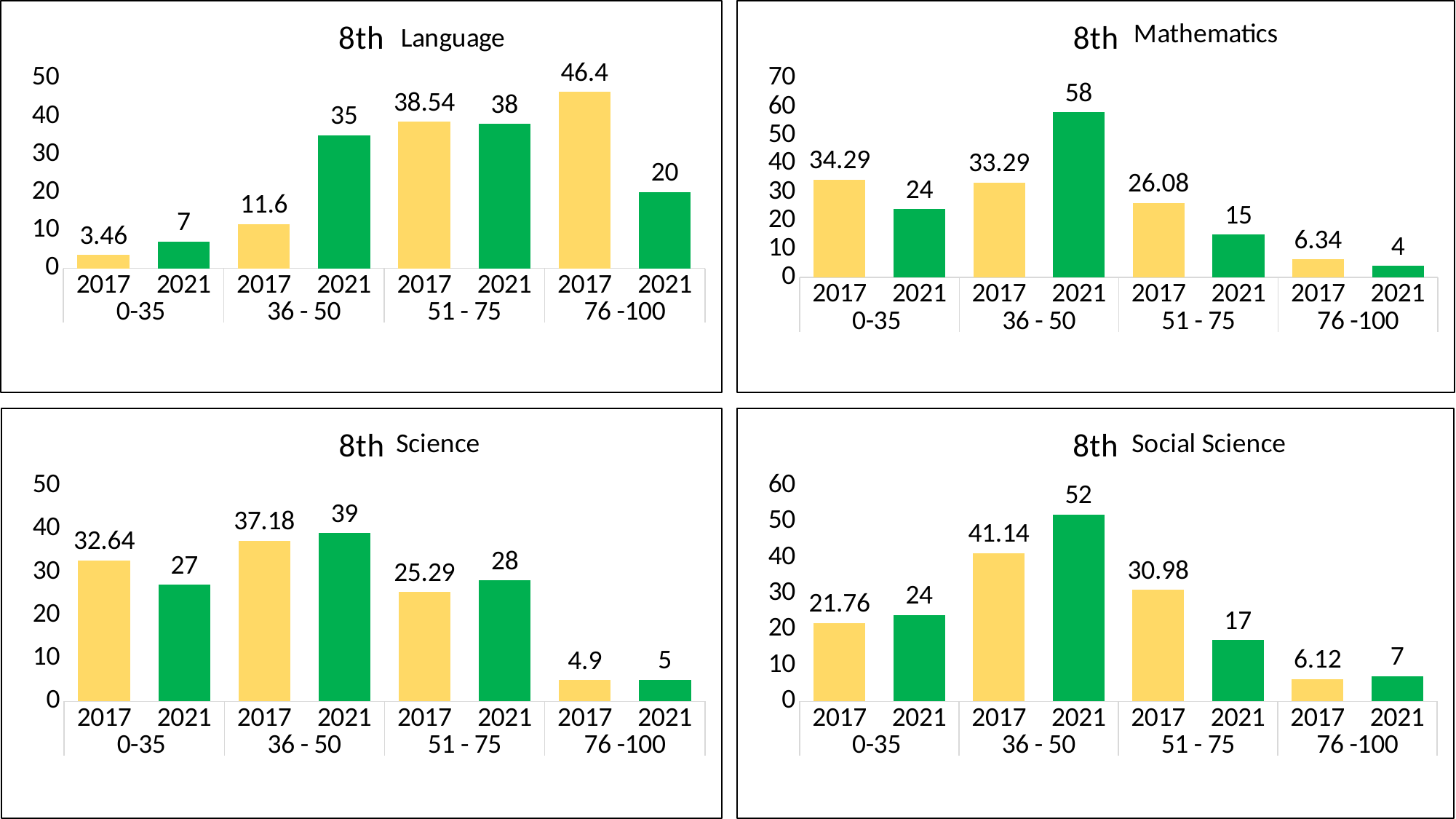
In the 8th Mathematics chart, which bar has the highest value? 2021 in 36 - 50 In the 8th Science chart, what is the value for 2017 in the 0-35 band? 32.64 In the 8th Social Science chart, what is the difference between the 2021 and 2017 values in the 36 - 50 band? 10.86 In the 8th Language chart, what colour are the 2021 bars? Green How many bars are plotted in the 8th Science chart? 8 In the 8th Social Science chart, what is the value for 2021 in the 51 - 75 band? 17 In the 8th Language chart, which bar has the lowest value? 2017 in 0-35 In the 8th Mathematics chart, what is the value for 2021 in the 36 - 50 band? 58 What type of chart is the 8th Social Science chart? Bar chart In the 8th Science chart, which is larger: the 2017 value or the 2021 value in the 0-35 band? 2017 In the 8th Mathematics chart, what is the difference between the 2017 and 2021 values in the 51 - 75 band? 11.08 In the 8th Language chart, what is the value for 2017 in the 76-100 band? 46.4